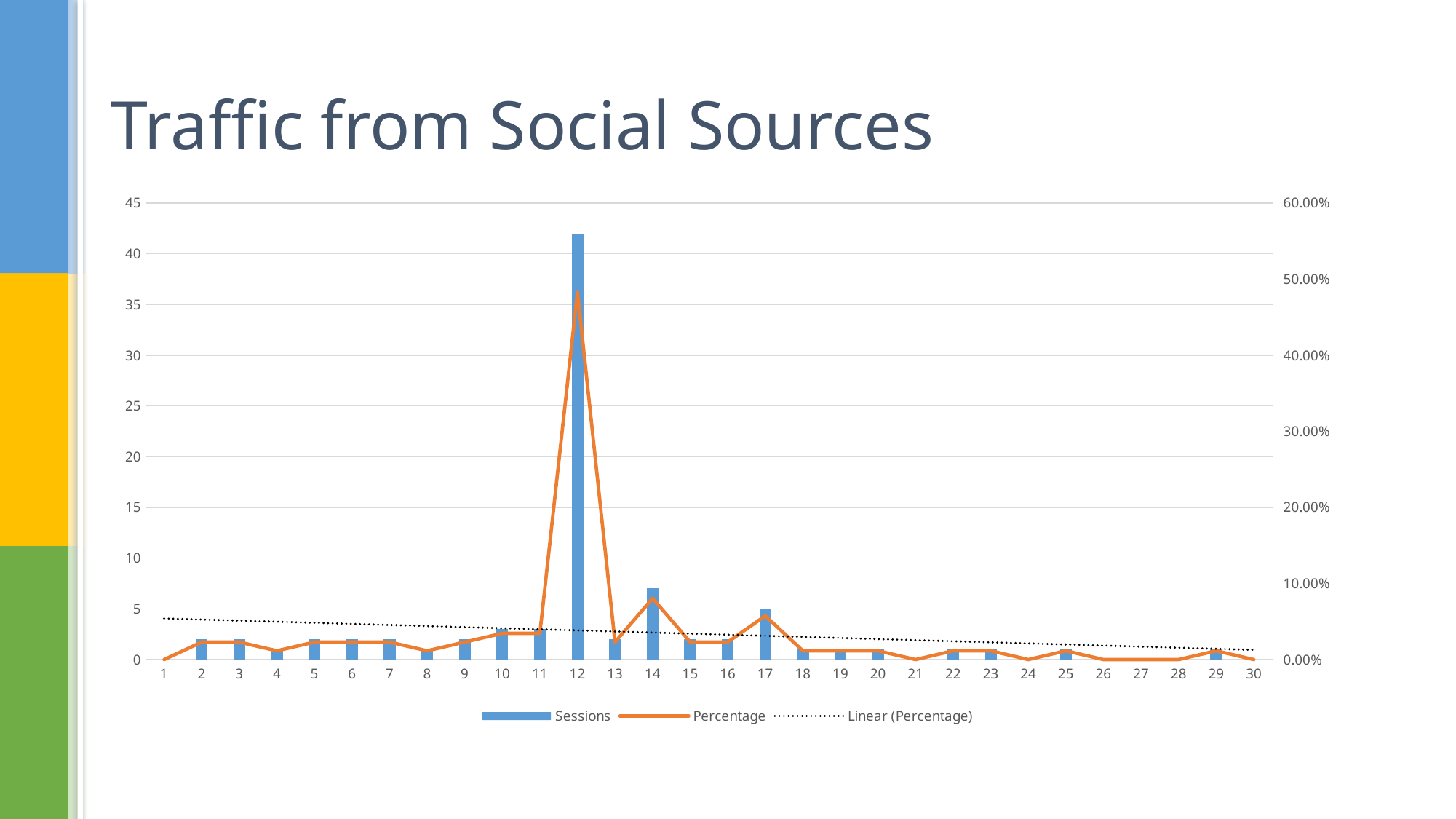
Does the Linear (Percentage) trendline rise or fall from left to right? fall How many categories are shown along the x axis of the chart? 30 Which series in the legend is drawn as a dotted line? Linear (Percentage) How many series does the chart's legend list? 3 Is the Percentage value for category 12 greater or less than 40.00%? greater Which category has the highest Sessions value? 12 Is the Sessions value for category 12 greater or less than 40? greater What is the title of the chart on the slide? Traffic from Social Sources What kind of chart is shown on the slide? Combined bar and line chart Which has the larger Sessions value, category 14 or category 17? 14 Is the Sessions value for category 14 greater or less than 10? less